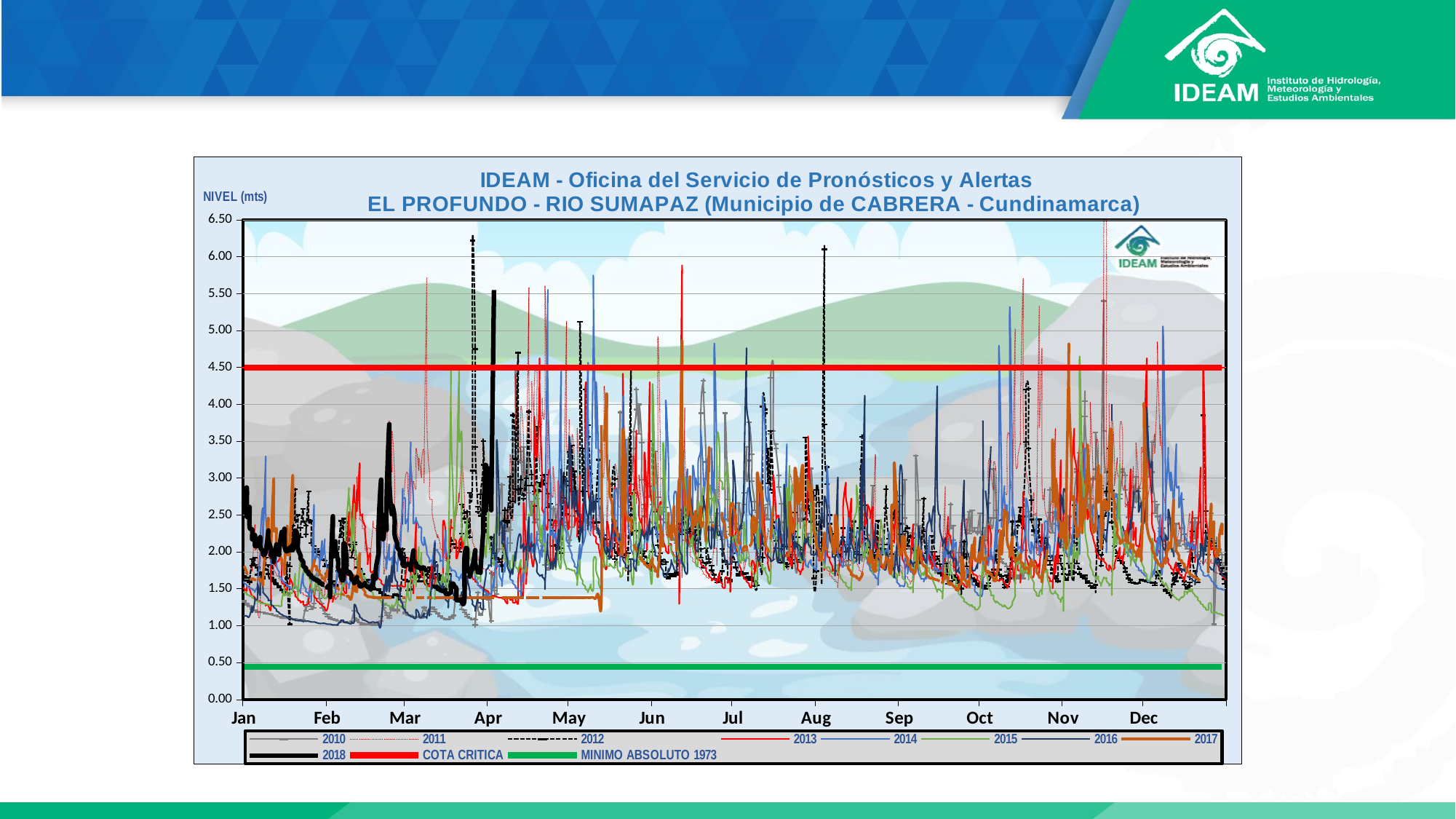
How many months are labelled along the x axis of the chart? 12 How many series does the chart legend list? 11 What kind of chart is shown on the slide? line chart Is the peak of the 2018 series in April greater or less than 5.00? greater Which year's series is drawn as a thick solid black line? 2018 What is the highest tick value shown on the y axis of the chart? 6.50 Is the peak of the 2018 series in February greater or less than 3.00? greater Is the MINIMO ABSOLUTO 1973 line greater or less than 1.00? less What is the second line of the chart title? EL PROFUNDO - RIO SUMAPAZ (Municipio de CABRERA - Cundinamarca) At what level (in mts) is the COTA CRITICA horizontal line drawn? 4.50 Which horizontal reference line is higher, COTA CRITICA or MINIMO ABSOLUTO 1973? COTA CRITICA